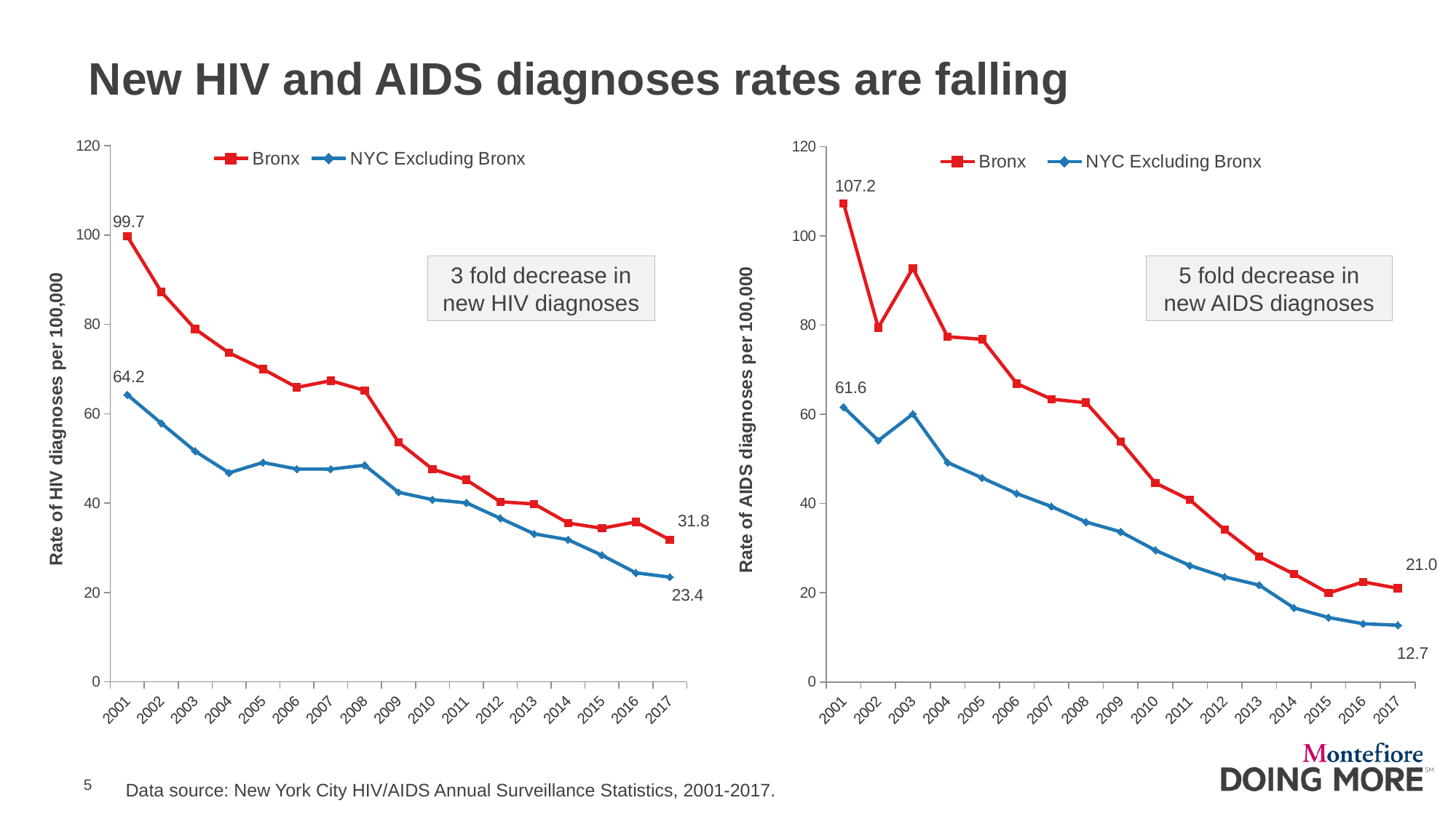
In the right chart (AIDS diagnoses), is the Bronx rate in 2003 greater or less than 80? greater In the right chart (AIDS diagnoses), what was the NYC Excluding Bronx rate in 2017? 12.7 How many series does the legend of the left chart (HIV diagnoses) list? 2 In the right chart (AIDS diagnoses), what was the Bronx rate of AIDS diagnoses per 100,000 in 2001? 107.2 In the left chart (HIV diagnoses), what is the difference between the Bronx and NYC Excluding Bronx rates in 2001? 35.5 In the left chart (HIV diagnoses), is the Bronx rate in 2009 greater or less than 60? less What kind of chart is the right chart (AIDS diagnoses)? Line chart In the left chart (HIV diagnoses), what was the NYC Excluding Bronx rate in 2017? 23.4 In the right chart (AIDS diagnoses), which series had the higher rate in 2017, Bronx or NYC Excluding Bronx? Bronx In the right chart (AIDS diagnoses), what is the difference between the Bronx rate in 2001 and the Bronx rate in 2017? 86.2 In the left chart (HIV diagnoses), what was the Bronx rate of HIV diagnoses per 100,000 in 2001? 99.7 In the left chart (HIV diagnoses), do the Bronx rates generally rise or fall from 2001 to 2017? Fall